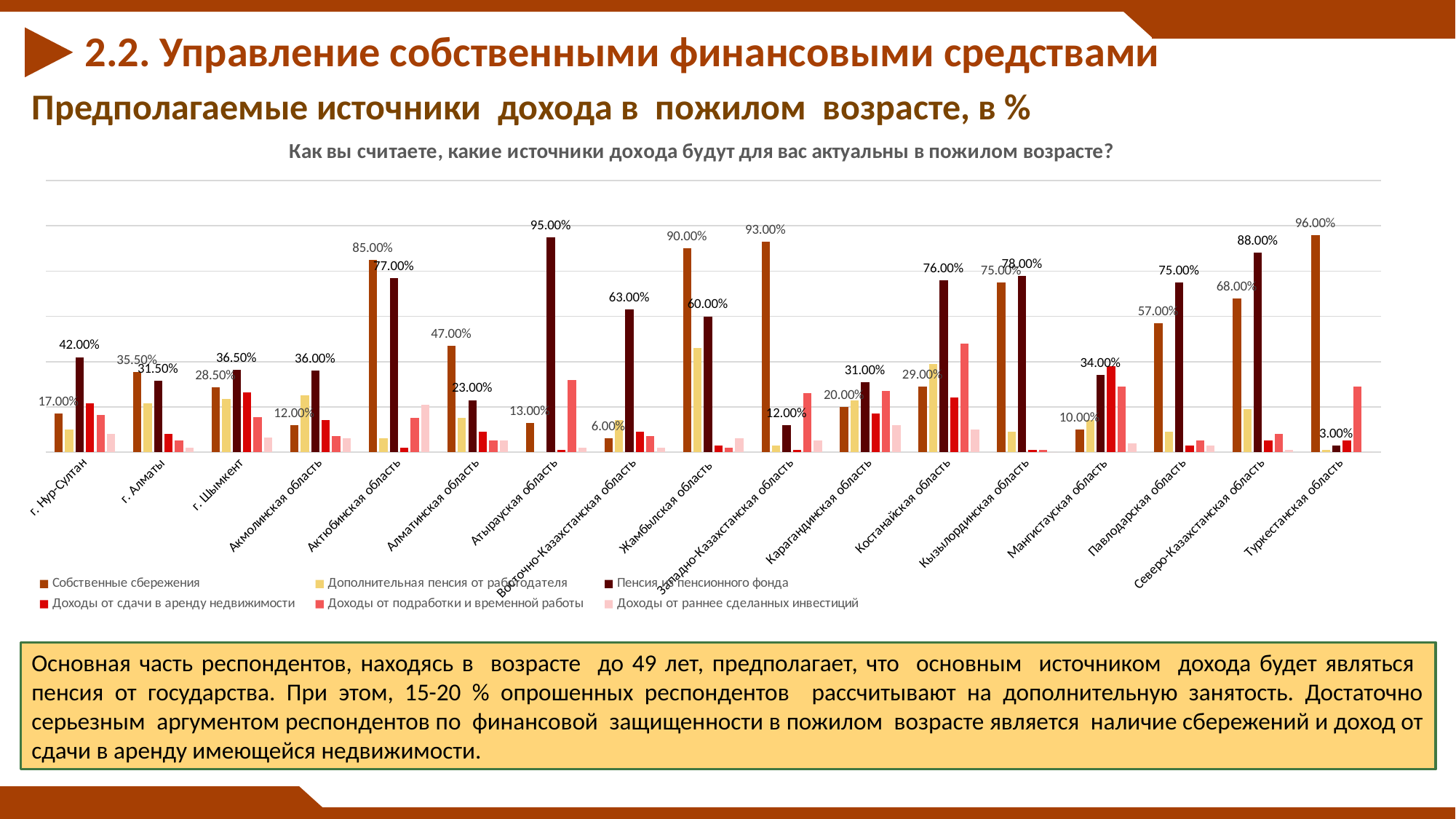
What is the difference between Собственные сбережения and Пенсия из пенсионного фонда in Актюбинская область? 8.00% Which region has the highest value for Собственные сбережения? Туркестанская область What is the value for Собственные сбережения in г. Нур-Султан? 17.00% How many regions are shown on the x axis of the chart? 17 Which region has the lowest value for Пенсия из пенсионного фонда? Туркестанская область How many series does the legend list? 6 What is the value for Пенсия из пенсионного фонда in Атырауская область? 95.00% In Жамбылская область, which is larger: Собственные сбережения or Пенсия из пенсионного фонда? Собственные сбережения Which region has the lowest value for Собственные сбережения? Восточно-Казахстанская область What is the value for Пенсия из пенсионного фонда in Мангистауская область? 34.00% What kind of chart is shown on the slide? Bar chart What is the value for Собственные сбережения in Туркестанская область? 96.00%